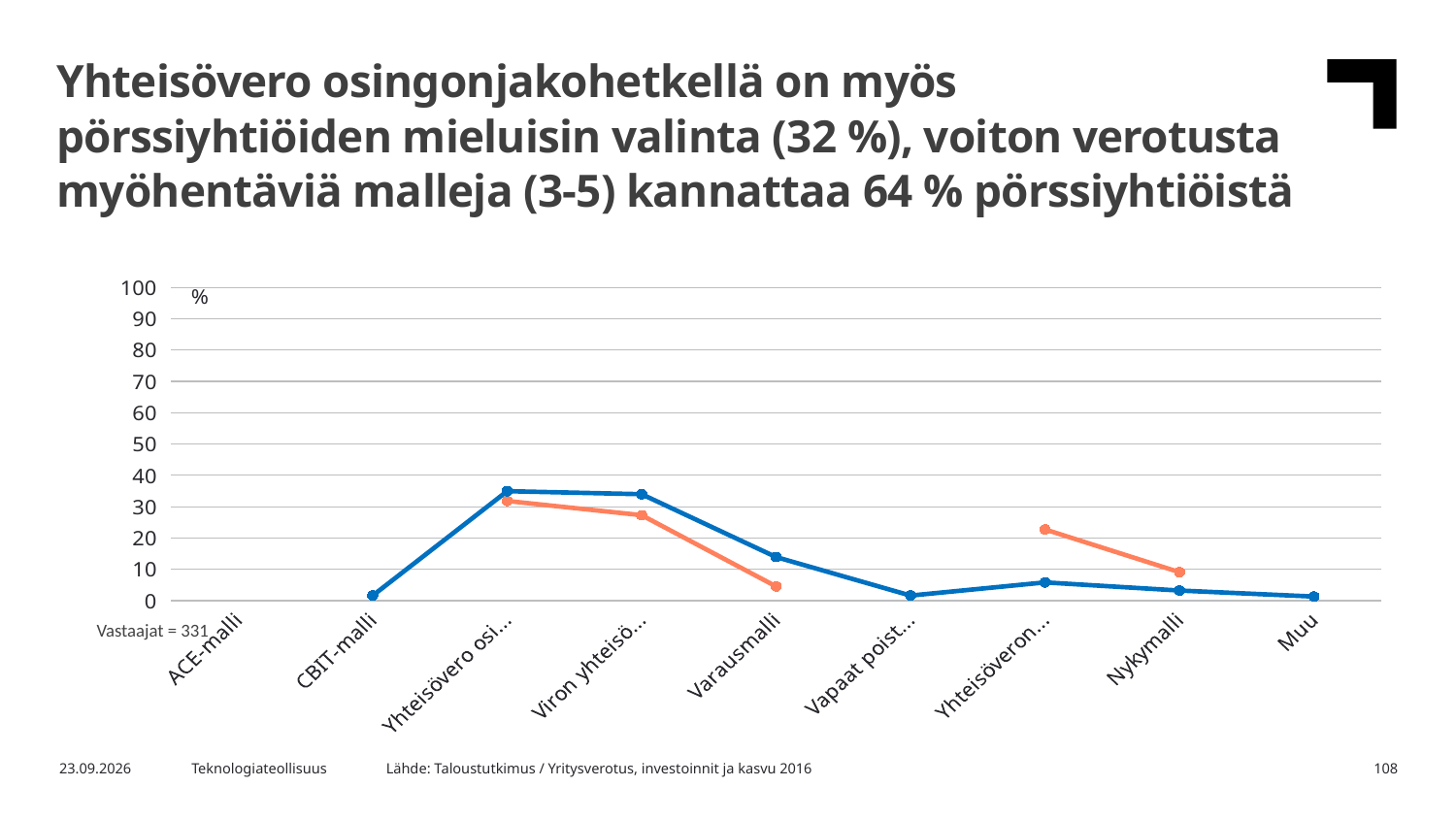
How many respondents (Vastaajat) are noted below the chart? 331 What kind of chart is shown on the slide? line chart Is the value of the orange line for Yhteisöveron... greater or less than 20? greater For Varausmalli, which line has the larger value, the blue line or the orange line? the blue line Is the value of the blue line for Varausmalli greater or less than 10? greater What unit is shown at the top of the y axis? % Does the blue line rise or fall between Viron yhteisö... and Vapaat poist...? fall Is the value of the blue line for Muu greater or less than 10? less For which category does the orange line reach its highest value? Yhteisövero osi... How many categories are shown on the x axis of the chart? 9